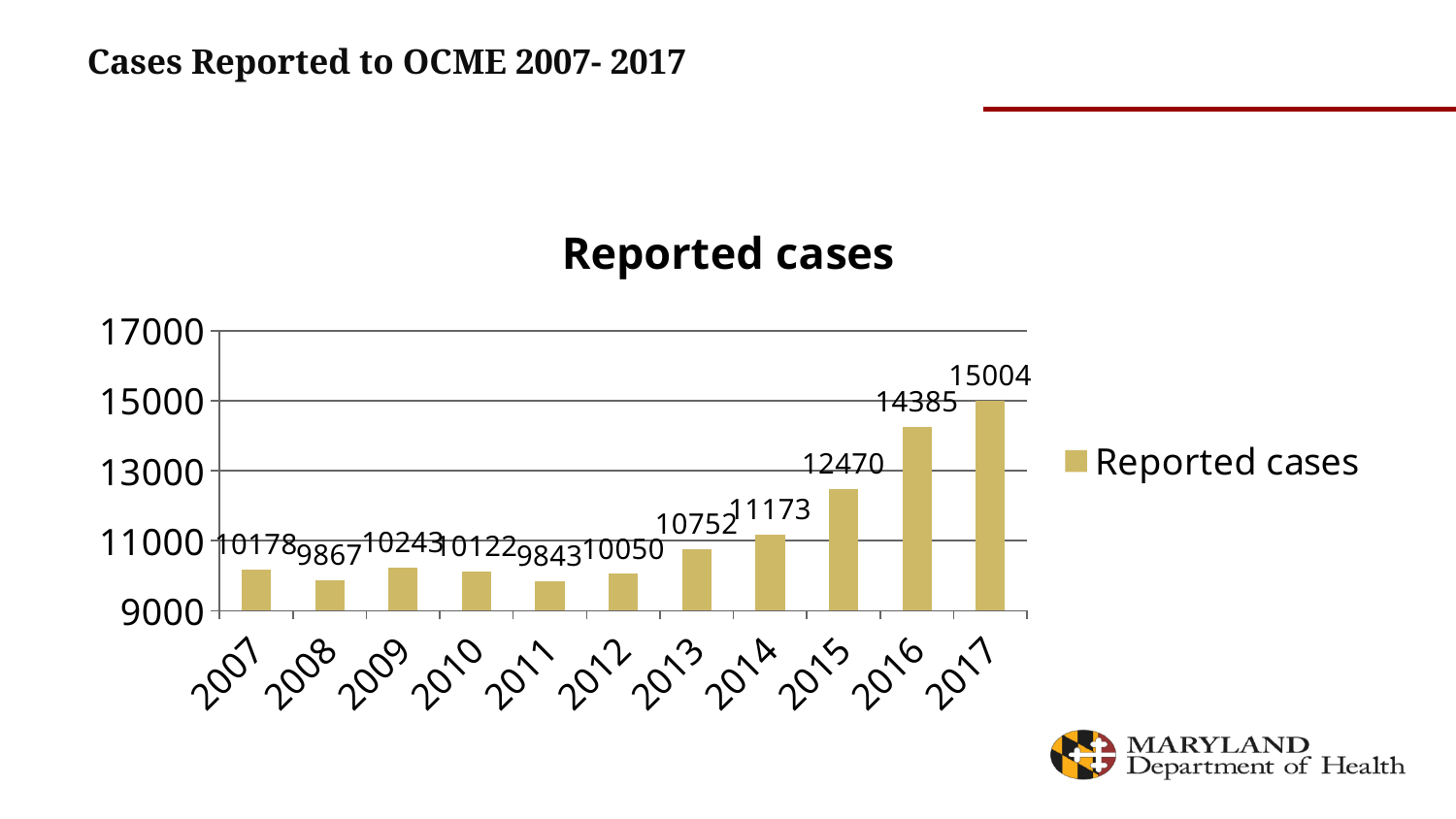
What is the value for 2014 in the Reported cases chart? 11173 What is the difference between the reported cases in 2015 and 2014? 1297 Which year has more reported cases, 2009 or 2013? 2013 Which year has the lowest number of reported cases? 2011 What kind of chart is shown on the slide? Bar chart Which year has the highest number of reported cases? 2017 What is the value for 2017 in the Reported cases chart? 15004 What is the difference between the reported cases in 2017 and 2016? 619 Is the value for 2016 greater or less than 13000? greater Do the reported cases generally rise or fall from 2012 to 2017? Rise What is the value for 2011 in the Reported cases chart? 9843 How many years are shown on the x axis of the chart? 11